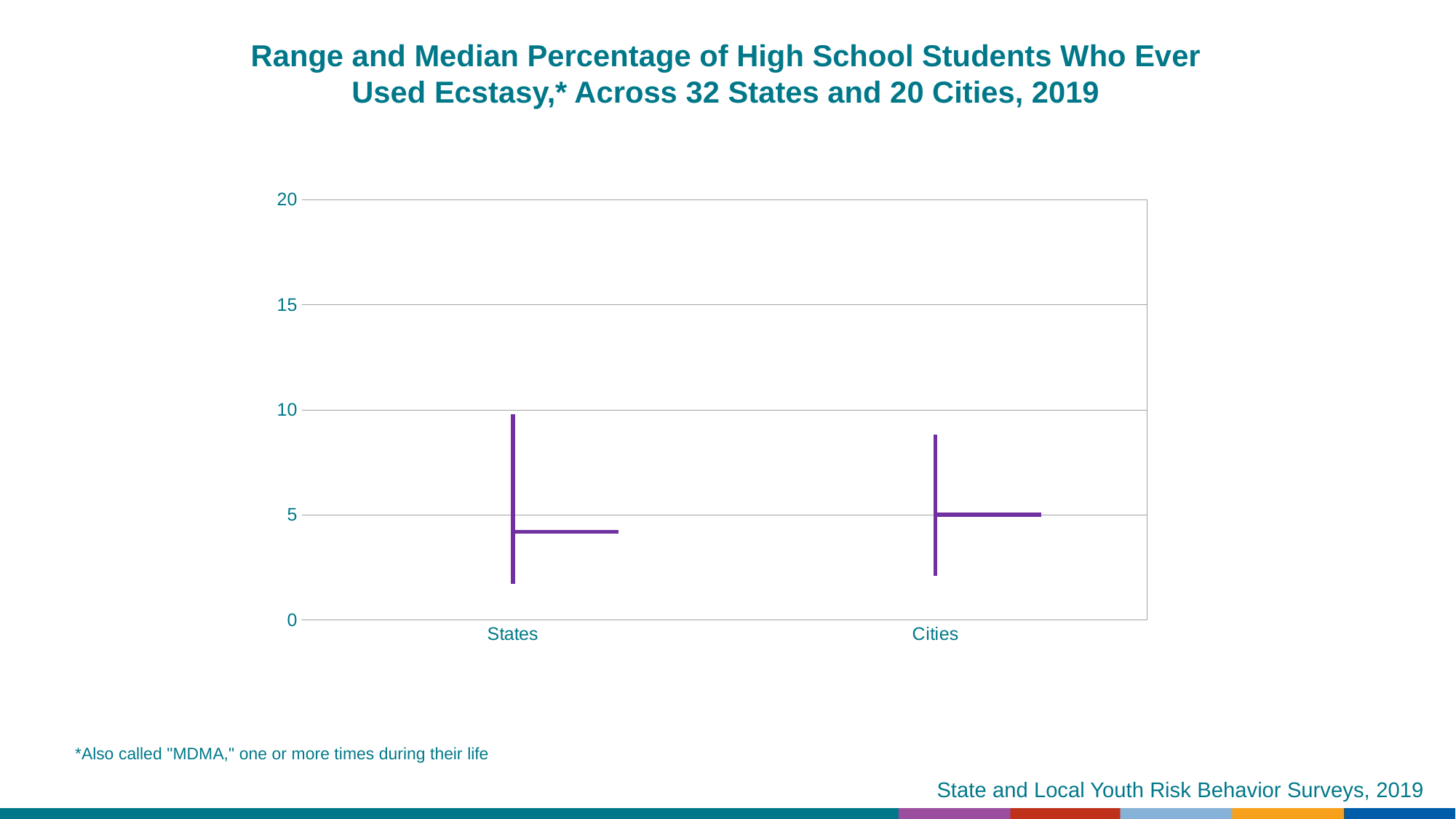
Is the median value for States greater or less than 5? less Is the bottom of the range for Cities greater or less than 5? less Which category has the higher median, States or Cities? Cities What are the two categories shown on the x axis? States and Cities How many categories are shown on the x axis of the chart? 2 Is the top of the range for States greater or less than 5? greater What is the highest value shown on the y axis? 20 What kind of chart is shown on the slide? range (high-low) chart with median markers Which category has the higher top of its range, States or Cities? States What year does the chart title refer to? 2019